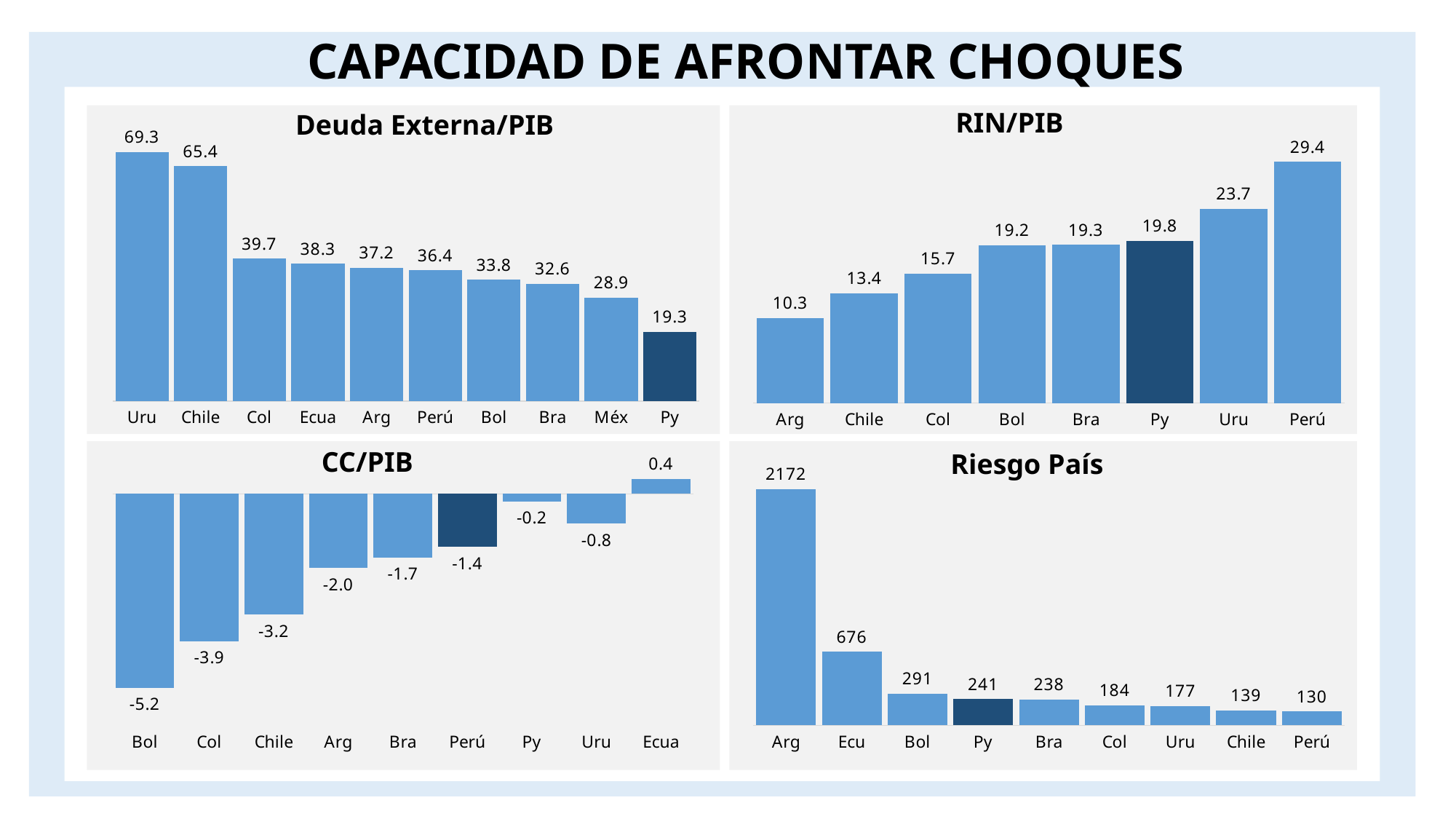
What kind of chart is the Riesgo País chart? bar chart In the Riesgo País chart, which is larger, Bol or Py? Bol In the RIN/PIB chart, what is the difference between Perú and Arg? 19.1 In the Deuda Externa/PIB chart, how many categories are shown? 10 In the Deuda Externa/PIB chart, what is the value for Uru? 69.3 In the Riesgo País chart, what is the value for Arg? 2172 In the CC/PIB chart, what is the value for Bol? -5.2 In the RIN/PIB chart, what is the value for Py? 19.8 In the CC/PIB chart, which category has the highest value? Ecua In the Deuda Externa/PIB chart, which category has the lowest value? Py In the RIN/PIB chart, do the values rise or fall from left to right? rise In the RIN/PIB chart, which category has the highest value? Perú